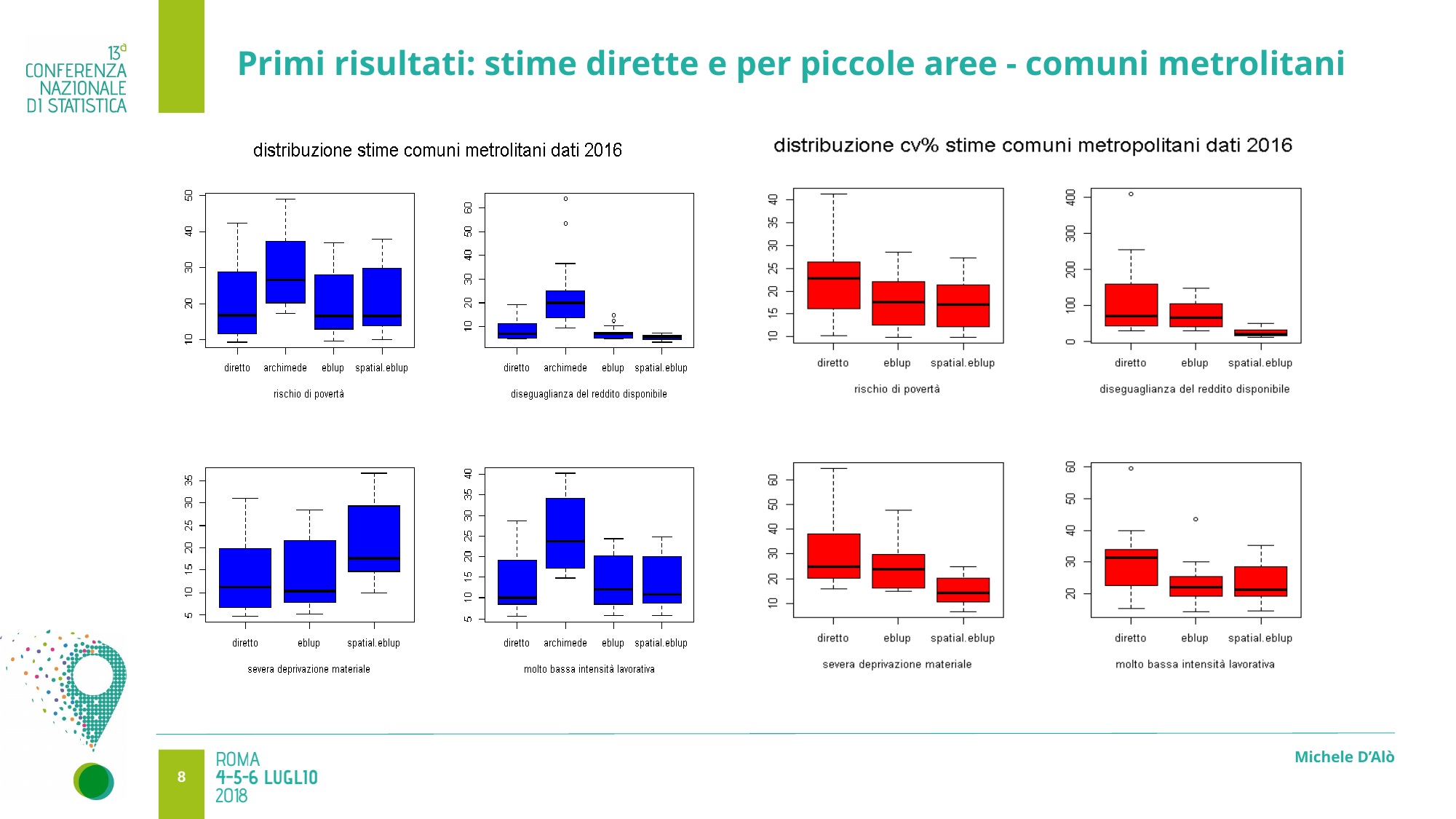
What colour are the boxes in the 'distribuzione stime comuni metrolitani dati 2016' chart? blue In the 'rischio di povertà' panel of the 'distribuzione stime comuni metrolitani dati 2016' chart, which has the higher median, archimede or diretto? archimede In the 'rischio di povertà' panel of the 'distribuzione stime comuni metrolitani dati 2016' chart, is the median for archimede greater or less than 20? greater In the 'rischio di povertà' panel of the 'distribuzione stime comuni metrolitani dati 2016' chart, how many categories are shown on the x axis? 4 In the 'severa deprivazione materiale' panel of the 'distribuzione stime comuni metrolitani dati 2016' chart, how many categories are shown on the x axis? 3 In the 'diseguaglianza del reddito disponibile' panel of the 'distribuzione cv% stime comuni metropolitani dati 2016' chart, which has the higher median, diretto or spatial.eblup? diretto In the 'severa deprivazione materiale' panel of the 'distribuzione cv% stime comuni metropolitani dati 2016' chart, which category has the lowest median? spatial.eblup What kind of chart is used in the panels on this slide? box plot In the 'molto bassa intensità lavorativa' panel of the 'distribuzione stime comuni metrolitani dati 2016' chart, which category has the highest median? archimede What colour are the boxes in the 'distribuzione cv% stime comuni metropolitani dati 2016' chart? red In the 'severa deprivazione materiale' panel of the 'distribuzione cv% stime comuni metropolitani dati 2016' chart, is the median for spatial.eblup greater or less than 20? less In the 'rischio di povertà' panel of the 'distribuzione cv% stime comuni metropolitani dati 2016' chart, is the median for diretto greater or less than 20? greater